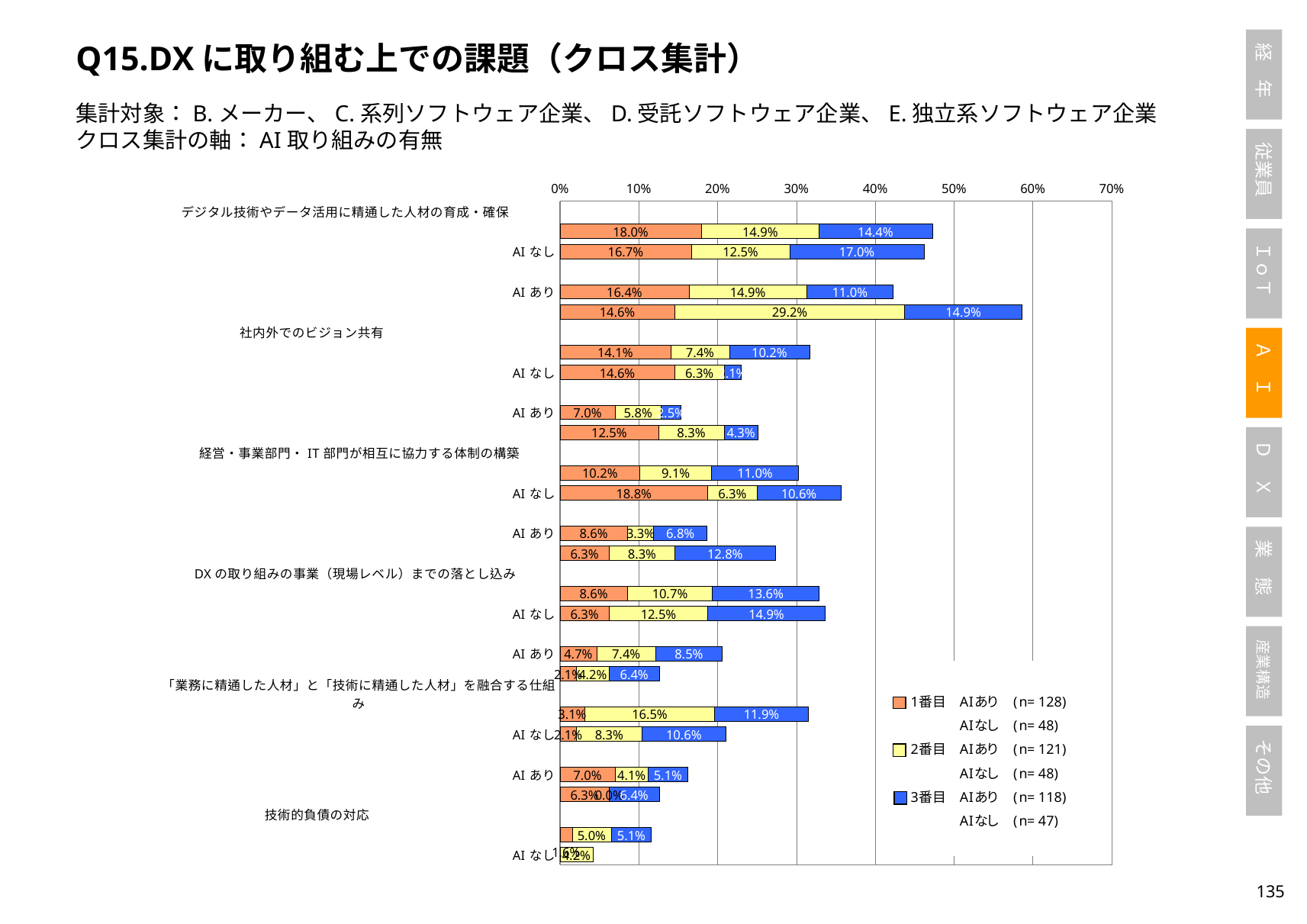
What is the total of the topmost bar (18.0%, 14.9%, 14.4%)? 47.3% What is the 1番目 (orange) value in the topmost bar of the chart? 18.0% What is the sample size (n) for 3番目 AIなし shown in the legend? 47 What is the largest single segment value labeled anywhere in the chart? 29.2% How many series does the legend list? 3 What kind of chart is shown on the slide? stacked bar chart What is the maximum value shown on the horizontal axis? 70% What is the 3番目 (blue) value in the topmost bar of the chart? 14.4% In the topmost bar, what is the difference between the 1番目 value (18.0%) and the 3番目 value (14.4%)? 3.6% What is the sample size (n) for 1番目 AIあり shown in the legend? 128 Is the total of the longest bar in the chart (14.6%, 29.2%, 14.9%) greater or less than 50%? greater In the topmost bar, which is larger: the 1番目 value or the 3番目 value? 1番目